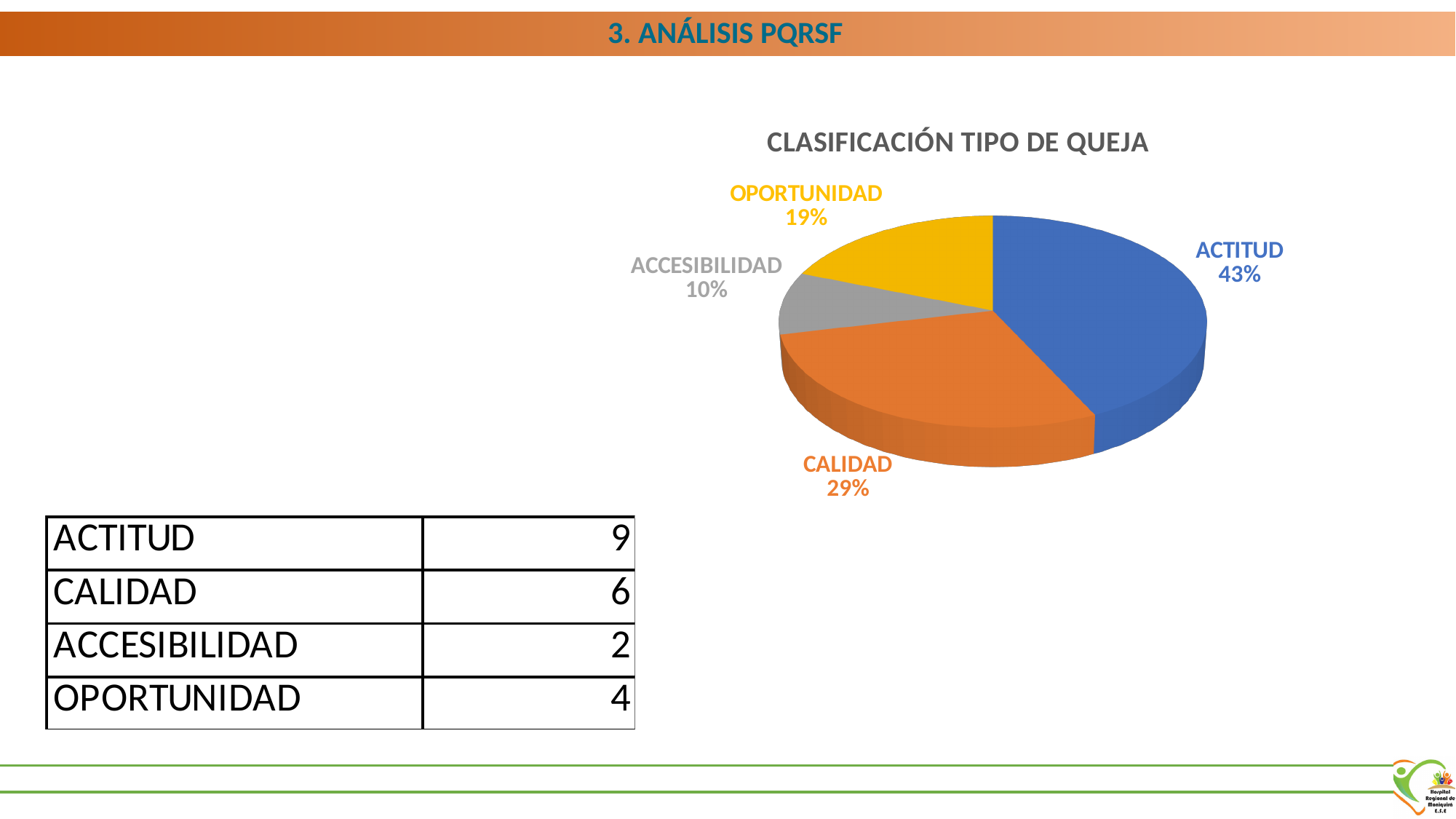
What percentage share does OPORTUNIDAD have in the pie chart? 19% What is the title of the chart? CLASIFICACIÓN TIPO DE QUEJA What colour is the CALIDAD slice in the pie chart? orange How many slices does the pie chart have? 4 What is the difference in percentage points between the ACTITUD and CALIDAD slices? 14% Which category has the largest slice in the pie chart? ACTITUD Which category has the smallest slice in the pie chart? ACCESIBILIDAD Which slice is larger, OPORTUNIDAD or ACCESIBILIDAD? OPORTUNIDAD What percentage share does ACCESIBILIDAD have in the pie chart? 10% What type of chart is shown on the slide? pie chart What percentage share does CALIDAD have in the pie chart? 29%